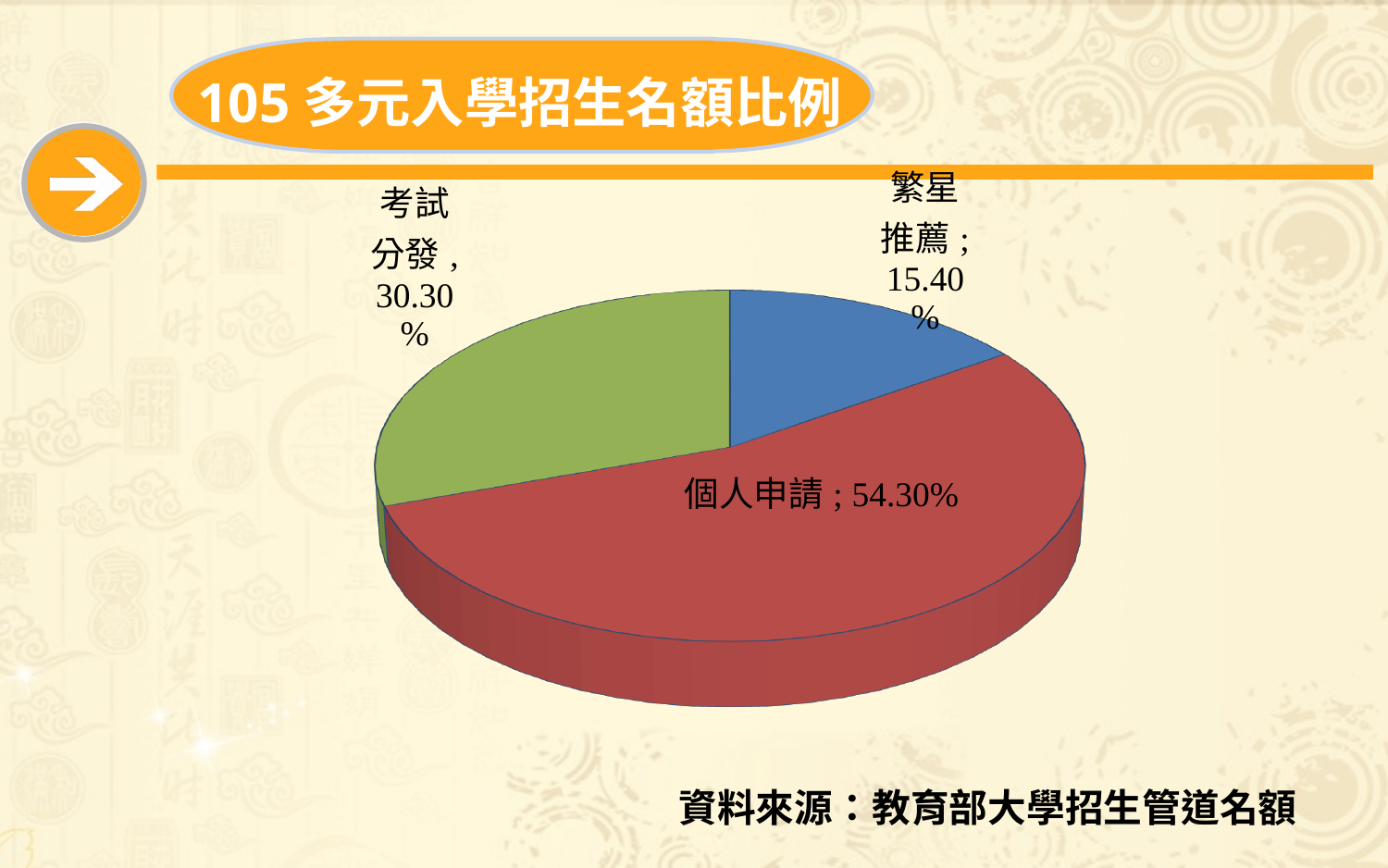
Which is larger, the share for 考試分發 or the share for 繁星推薦? 考試分發 What kind of chart is shown on the slide? Pie chart Which category has the largest share of the pie? 個人申請 What is the difference between the share for 個人申請 and the share for 考試分發? 24.00% How many slices does the pie chart have? 3 What is the share for 個人申請? 54.30% What is the share for 考試分發? 30.30% What colour is the slice for 個人申請? Red Which category has the smallest share of the pie? 繁星推薦 What is the difference between the share for 考試分發 and the share for 繁星推薦? 14.90% What is the title of the chart on the slide? 105 多元入學招生名額比例 What is the share for 繁星推薦? 15.40%